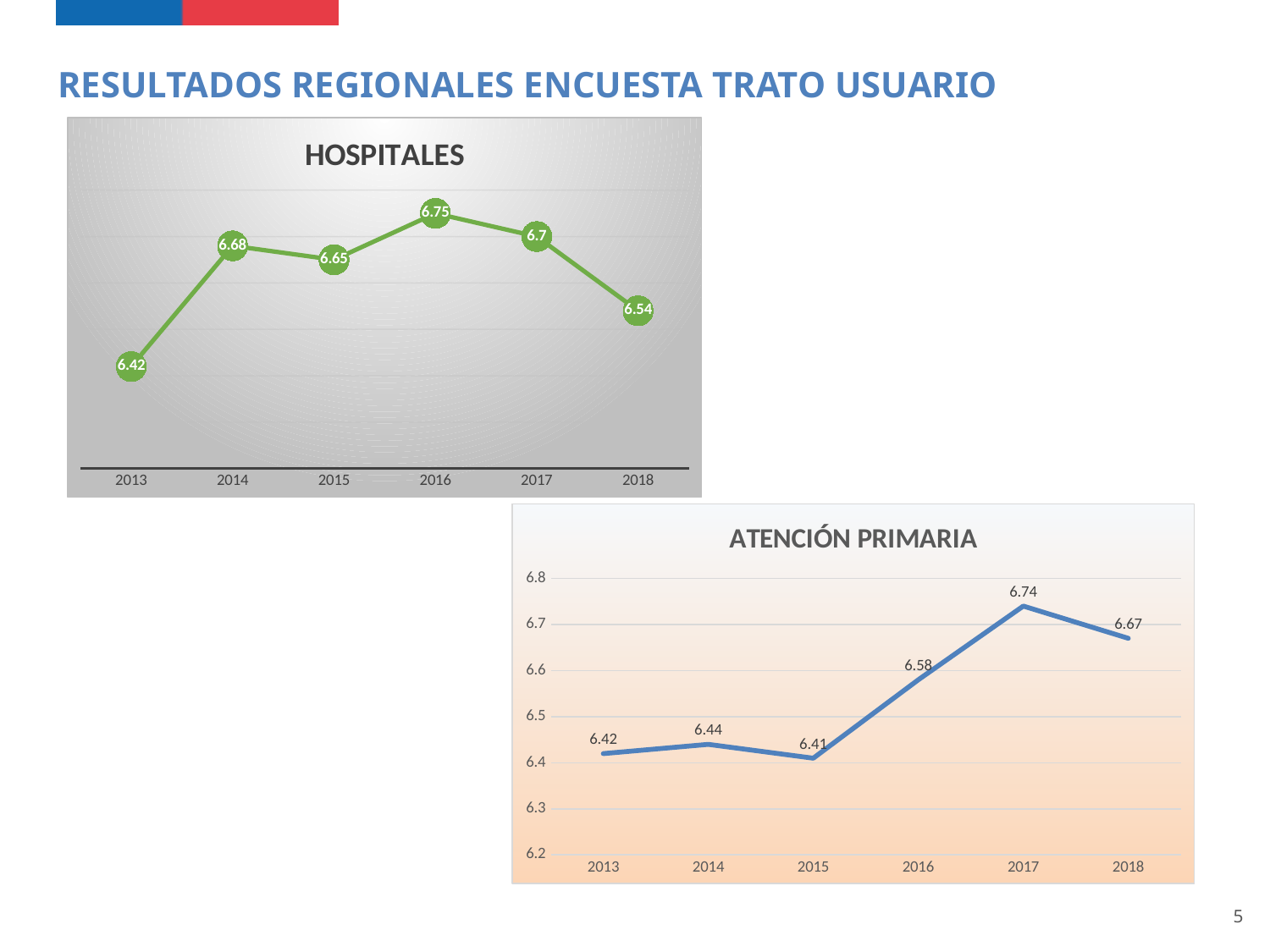
In the ATENCIÓN PRIMARIA chart, what is the difference between the 2017 and 2013 values? 0.32 In the HOSPITALES chart, which year has the lowest value? 2013 In the HOSPITALES chart, what colour is the line? Green In the ATENCIÓN PRIMARIA chart, is the value for 2016 greater or less than 6.5? greater In the ATENCIÓN PRIMARIA chart, which year has the highest value? 2017 In the ATENCIÓN PRIMARIA chart, which year has the lowest value? 2015 In the HOSPITALES chart, what is the value for 2016? 6.75 What kind of chart is the HOSPITALES chart? Line chart In the HOSPITALES chart, what is the difference between the 2016 and 2018 values? 0.21 In the HOSPITALES chart, how many data points are plotted? 6 In the ATENCIÓN PRIMARIA chart, which is larger, the value for 2014 or the value for 2018? 2018 In the ATENCIÓN PRIMARIA chart, what is the value for 2017? 6.74